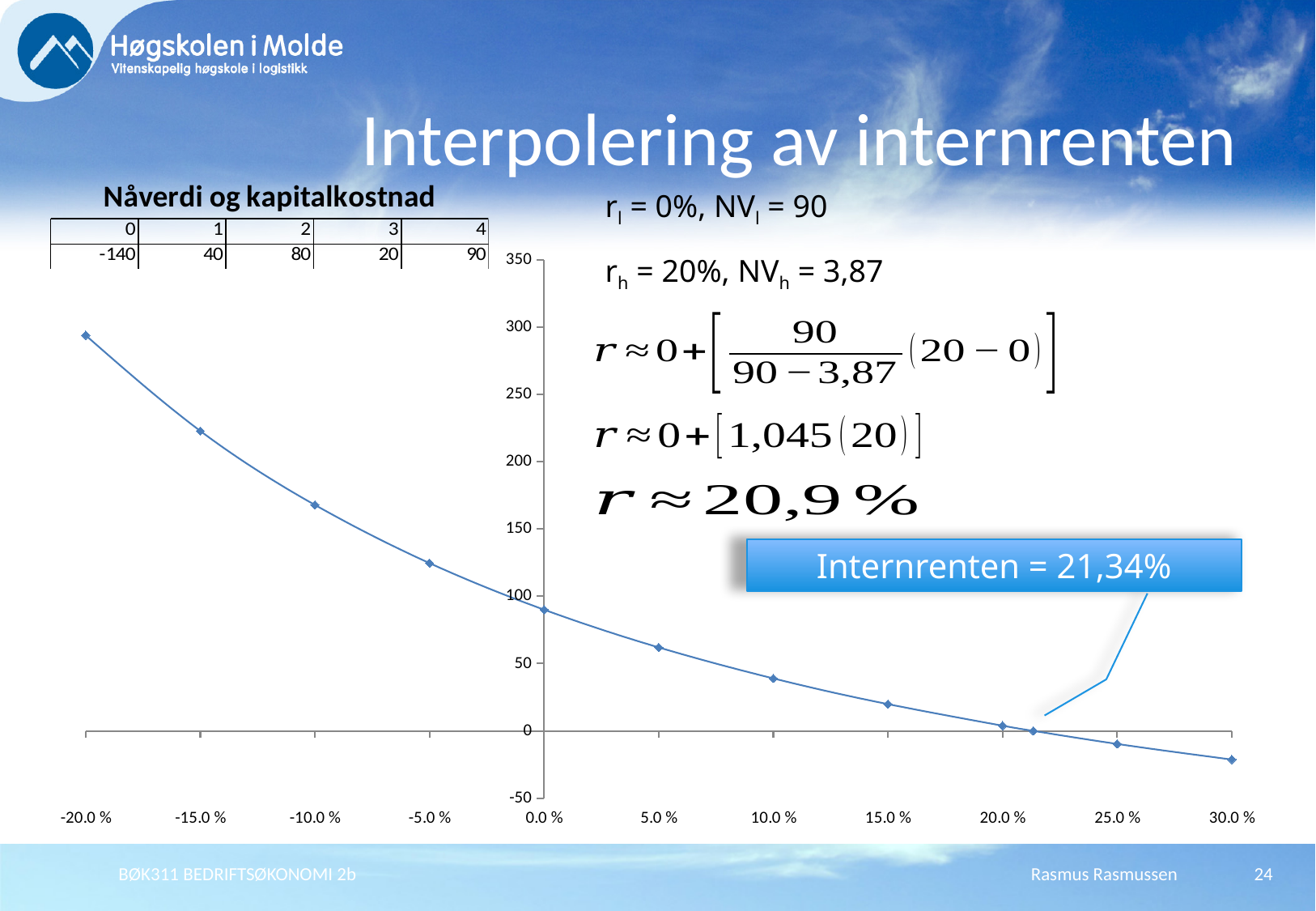
At which x-axis value is the plotted value highest? -20.0 % Do the plotted values rise or fall as the x-axis value increases from -20.0 % to 30.0 %? fall Is the value at 30.0 % greater or less than 0? less Is the value at -20.0 % greater or less than 250? greater According to the slide, what is the net present value (NV) at a rate of 0%? 90 Is the value at -5.0 % greater or less than 100? greater What is the title of the chart? Nåverdi og kapitalkostnad At which x-axis value is the plotted value lowest? 30.0 % What kind of chart is shown on the slide? line chart Which has the larger plotted value, -10.0 % or 10.0 %? -10.0 %